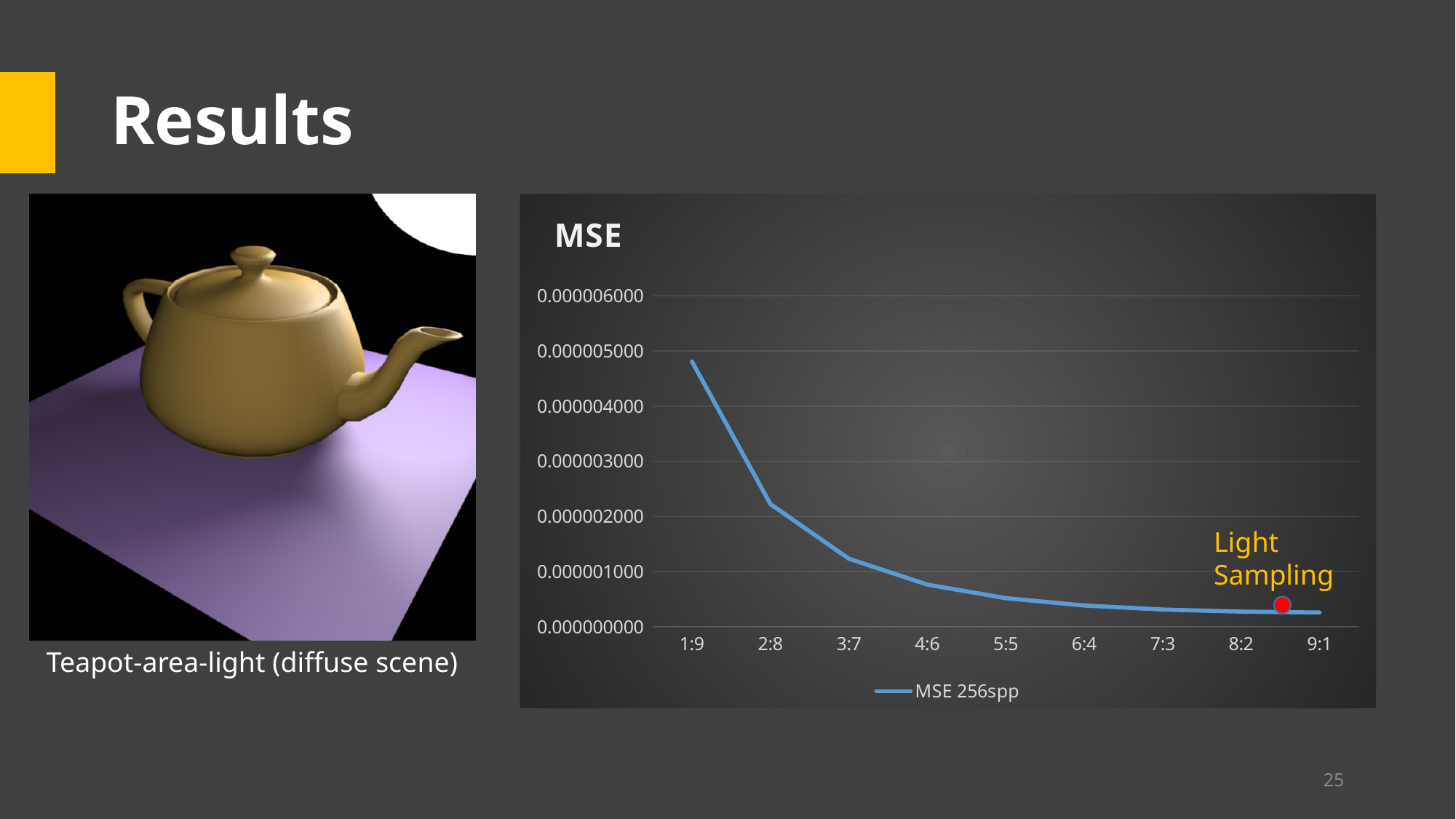
Is the MSE value for 4:6 greater or less than 0.000001000? less What is the title of the chart? MSE What kind of chart is shown on the slide? line chart Is the MSE value for 1:9 greater or less than 0.000004000? greater Which has the larger MSE value, 1:9 or 2:8? 1:9 Is the MSE value for 9:1 greater or less than 0.000001000? less Which category has the highest MSE value? 1:9 How many categories are plotted along the x axis of the chart? 9 How many series does the chart legend list? 1 Do the MSE values rise or fall as you move from 1:9 to 9:1 along the x axis? fall What is the name of the series shown in the chart legend? MSE 256spp